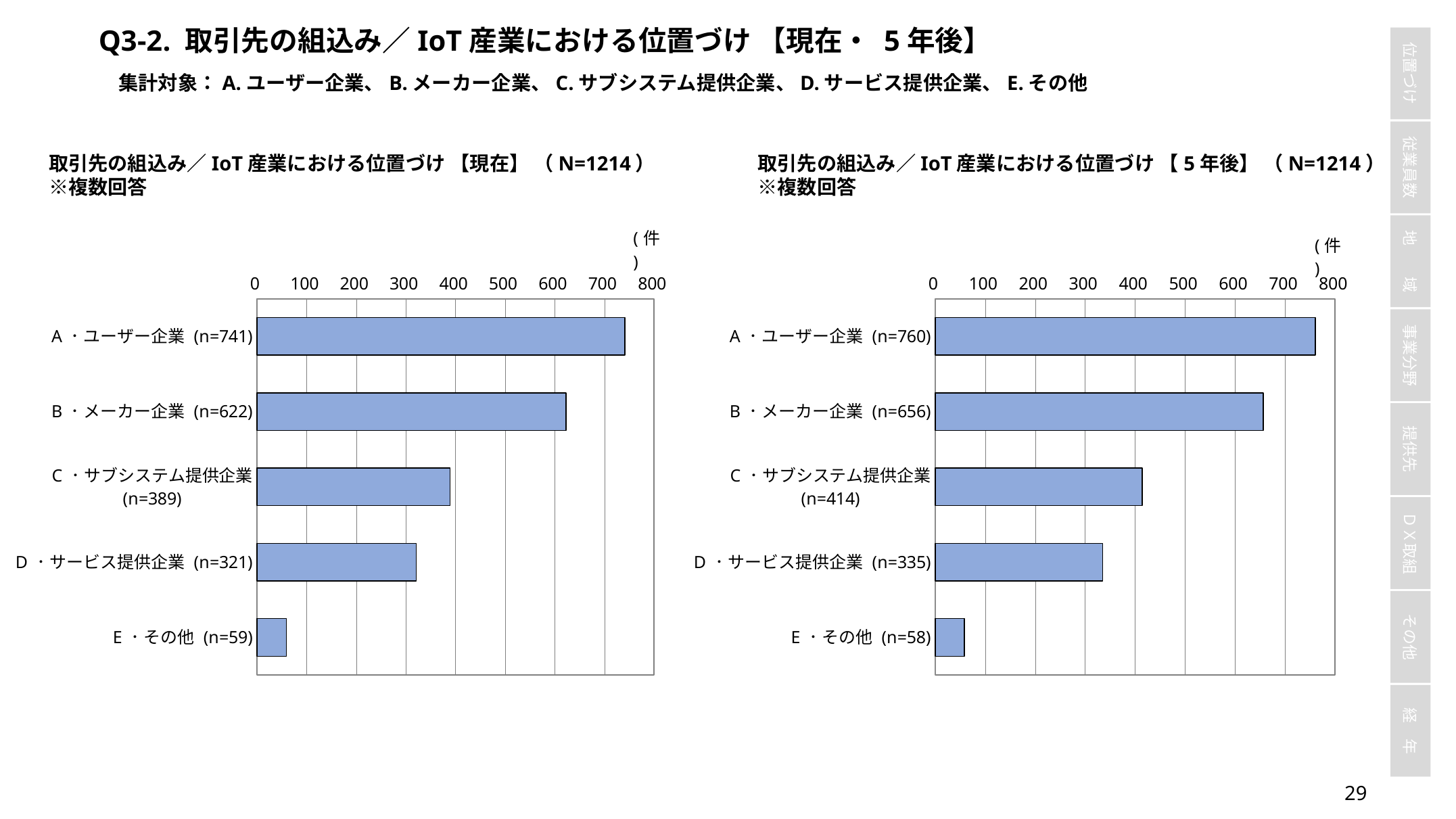
What is the N value shown in the title of the left chart (【現在】)? N=1214 In the left chart (【現在】), which is larger, the value for C・サブシステム提供企業 or D・サービス提供企業? C・サブシステム提供企業 What kind of chart is the right chart (【5年後】)? bar chart In the right chart (【5年後】), what is the value for C・サブシステム提供企業? 414 How many categories are shown in the left chart (【現在】)? 5 In the right chart (【5年後】), what is the difference between the values for C・サブシステム提供企業 and D・サービス提供企業? 79 In the left chart (【現在】), what is the difference between the values for A・ユーザー企業 and B・メーカー企業? 119 In the right chart (【5年後】), which category has the highest value? A・ユーザー企業 In the right chart (【5年後】), what is the value for E・その他? 58 In the left chart (【現在】), which category has the lowest value? E・その他 In the left chart (【現在】), what is the value for A・ユーザー企業? 741 In the right chart (【5年後】), is the value for B・メーカー企業 greater or less than 600? greater